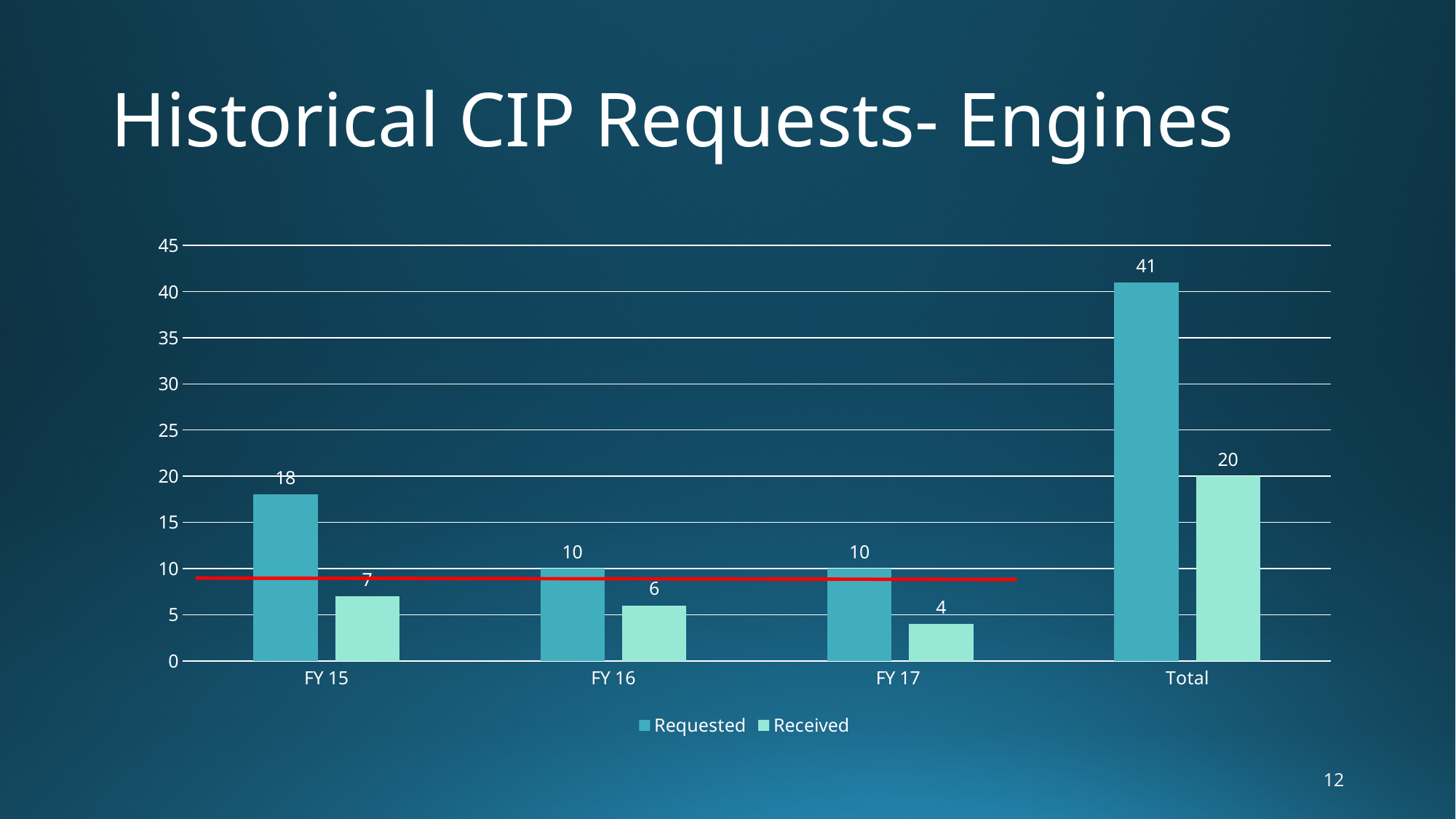
What is the Received value for FY 17? 4 Do the Received values rise or fall from FY 15 to FY 17? Fall Excluding Total, which fiscal year has the highest Requested value? FY 15 What kind of chart is shown on the slide? Bar chart How many series does the legend list? 2 Which is larger, the Received value for FY 15 or the Received value for FY 16? FY 15 What is the difference between Requested and Received for FY 16? 4 What is the Requested value for FY 15? 18 What is the difference between the Total Requested and Total Received values? 21 How many categories are shown on the x axis? 4 What is the Requested value for Total? 41 Which category has the lowest Received value? FY 17